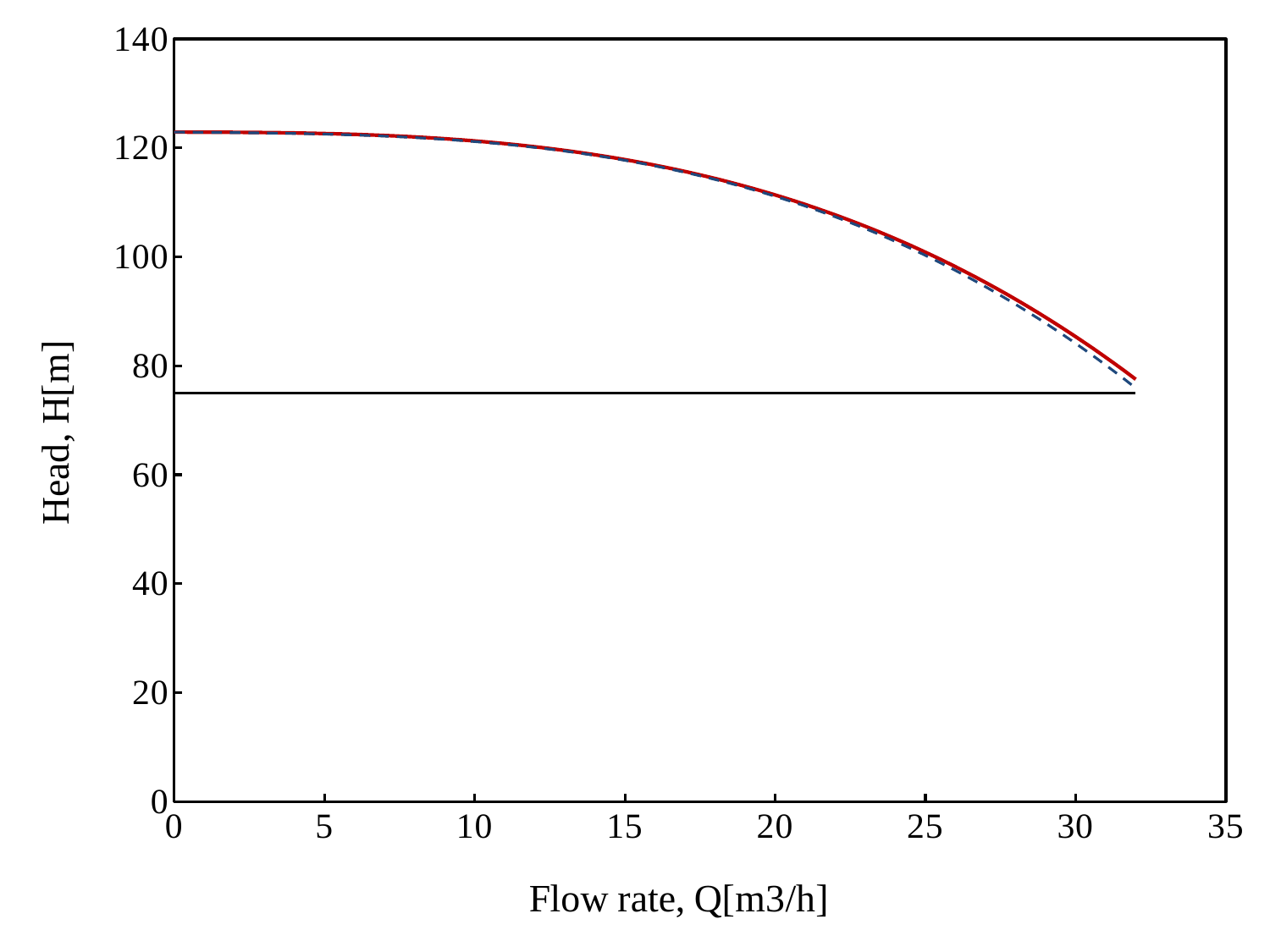
Is the value of the horizontal black line greater or less than 60? greater Does the red curve rise or fall as the flow rate increases along the x axis? fall Is the value of the horizontal black line greater or less than 80? less Is the head of the red curve at a flow rate of 0 greater or less than 120? greater What kind of chart is shown on the slide? line chart What is the label of the y axis? Head, H[m] What is the maximum value shown on the y axis? 140 What is the label of the x axis? Flow rate, Q[m3/h] How many lines are plotted on the chart? 3